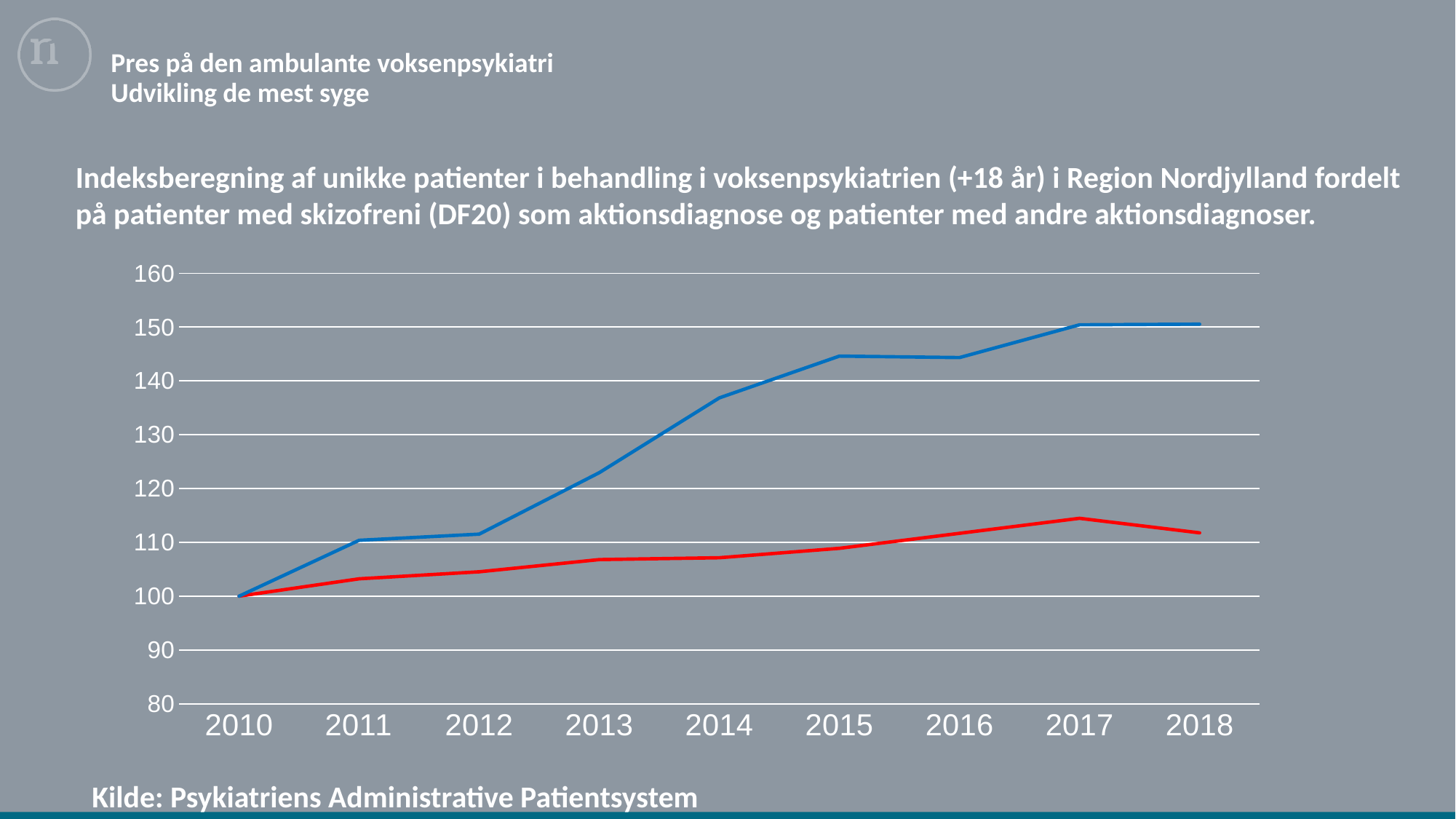
Does the blue line rise or fall from 2010 to 2017? Rises Is the value of the red line in 2018 greater or less than 120? less What source is cited below the chart? Psykiatriens Administrative Patientsystem In 2016, which line has the higher value, the blue line or the red line? The blue line What is the value of the blue line in 2010? 100 How many years are shown on the x axis of the chart? 9 What type of chart is shown on the slide? Line chart Is the value of the blue line in 2014 greater or less than 130? greater In which year does the red line reach its highest value? 2017 What is the value of the red line in 2010? 100 How many lines (data series) are plotted on the chart? 2 Is the value of the blue line in 2018 greater or less than 140? greater